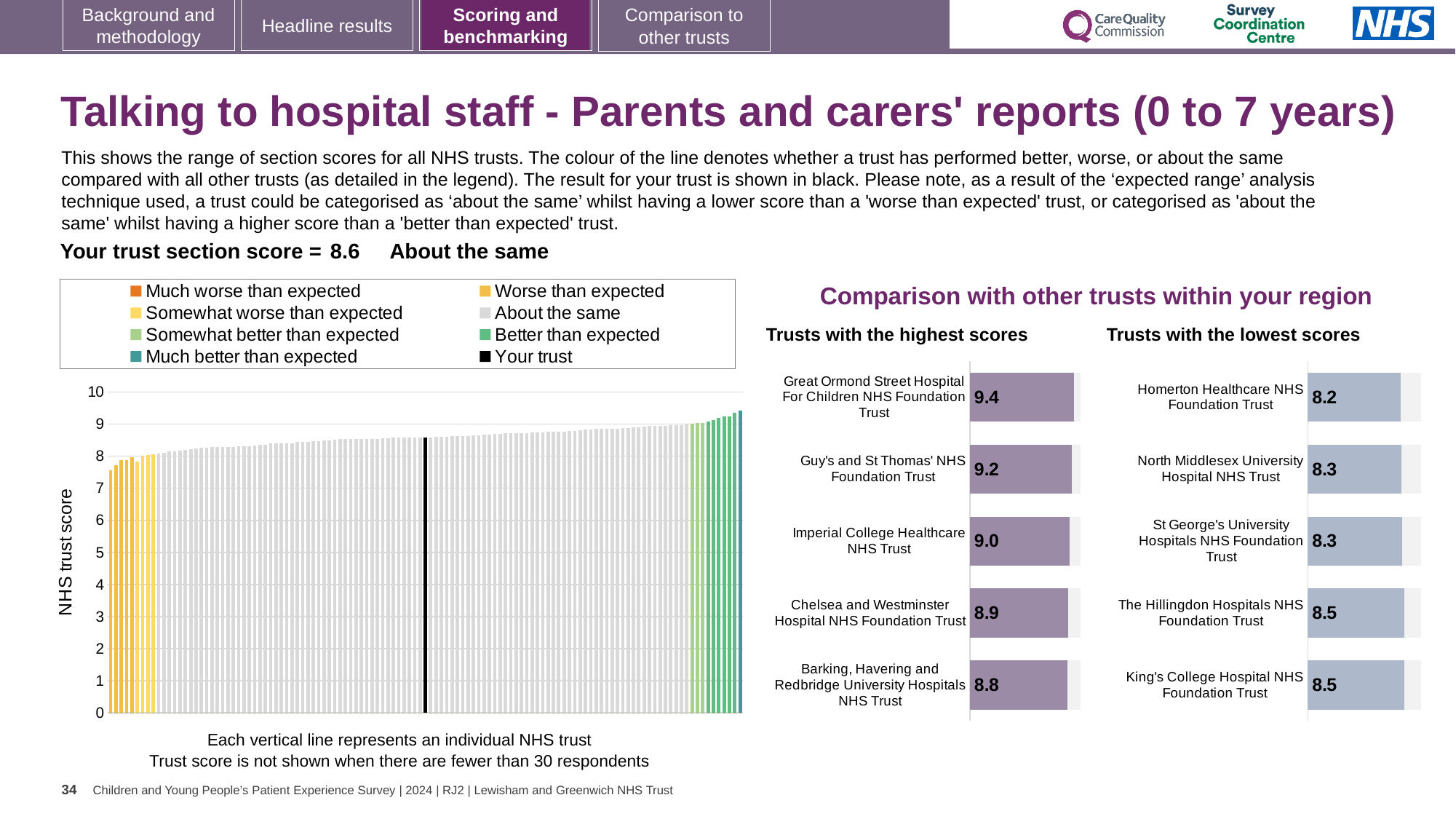
In the 'Trusts with the highest scores' chart, which trust has the lowest score? Barking, Havering and Redbridge University Hospitals NHS Trust In the 'Trusts with the highest scores' chart, what is the score for Imperial College Healthcare NHS Trust? 9.0 In the 'Trusts with the lowest scores' chart, what is the score for Homerton Healthcare NHS Foundation Trust? 8.2 How many trusts are shown in the 'Trusts with the highest scores' chart? 5 In the 'Trusts with the lowest scores' chart, which has the higher score: North Middlesex University Hospital NHS Trust or King's College Hospital NHS Foundation Trust? King's College Hospital NHS Foundation Trust How many entries does the legend of the NHS trust score chart on the left list? 8 In the 'Trusts with the highest scores' chart, what is the score for Great Ormond Street Hospital For Children NHS Foundation Trust? 9.4 In the NHS trust score chart on the left, is the value of the leftmost (lowest) bar greater or less than 8? less In the 'Trusts with the lowest scores' chart, which trust has the lowest score? Homerton Healthcare NHS Foundation Trust In the 'Trusts with the lowest scores' chart, what is the score for The Hillingdon Hospitals NHS Foundation Trust? 8.5 In the 'Trusts with the highest scores' chart, what is the difference between the scores of Great Ormond Street Hospital For Children NHS Foundation Trust and Guy's and St Thomas' NHS Foundation Trust? 0.2 In the NHS trust score chart on the left, what is the section score for your trust? 8.6